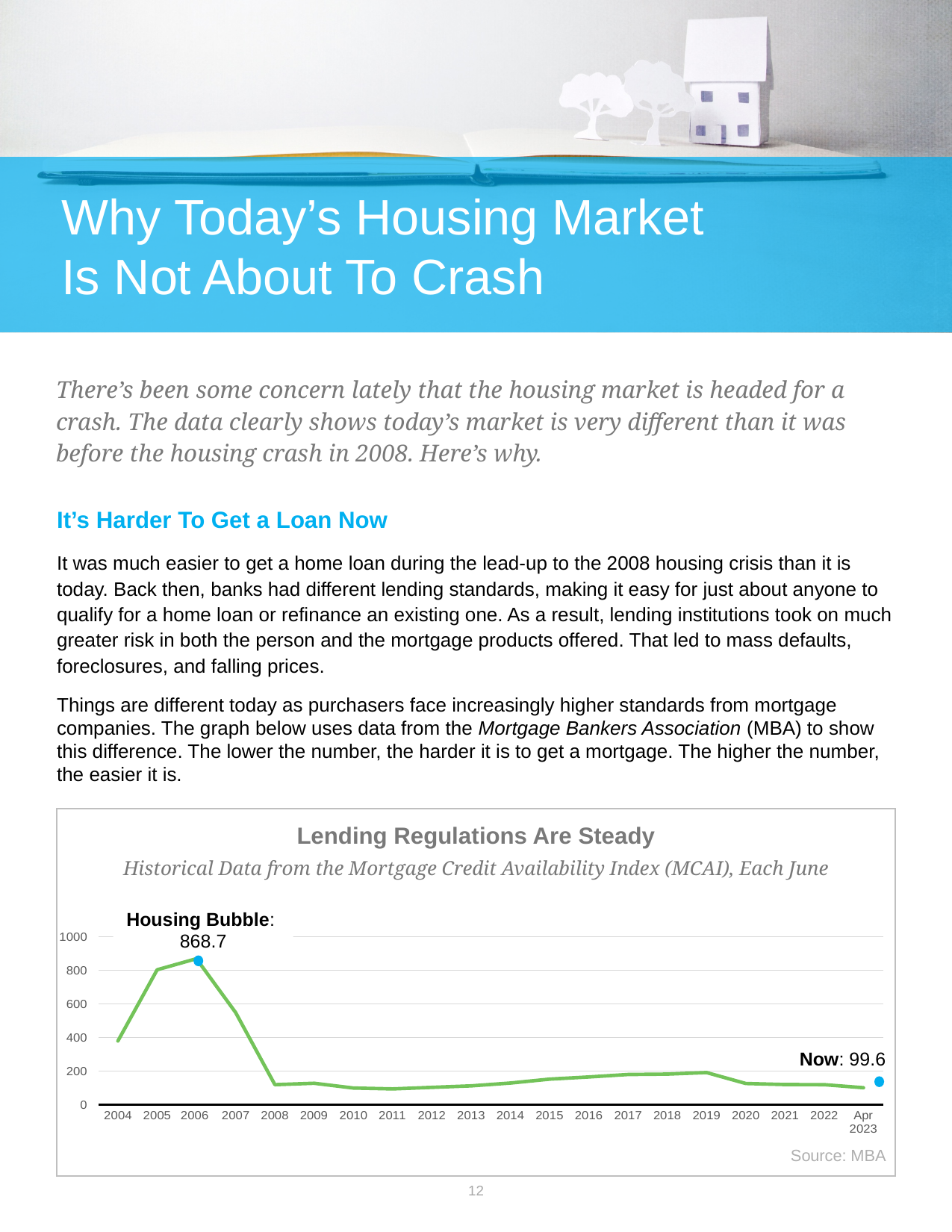
What is the value labeled "Housing Bubble" on the chart? 868.7 Which is larger, the value for 2006 or the value for Apr 2023? 2006 What is the value labeled "Now" for Apr 2023? 99.6 In which year does the line reach its highest point? 2006 Is the value for 2004 greater or less than 200? greater Do the values rise or fall from 2006 to 2008? fall What is the difference between the Housing Bubble value and the Now value? 769.1 What kind of chart is shown on the slide? line chart What is the title of the chart? Lending Regulations Are Steady How many points are plotted along the x axis? 20 Is the value for 2008 greater or less than 200? less Is the value for 2005 greater or less than 600? greater